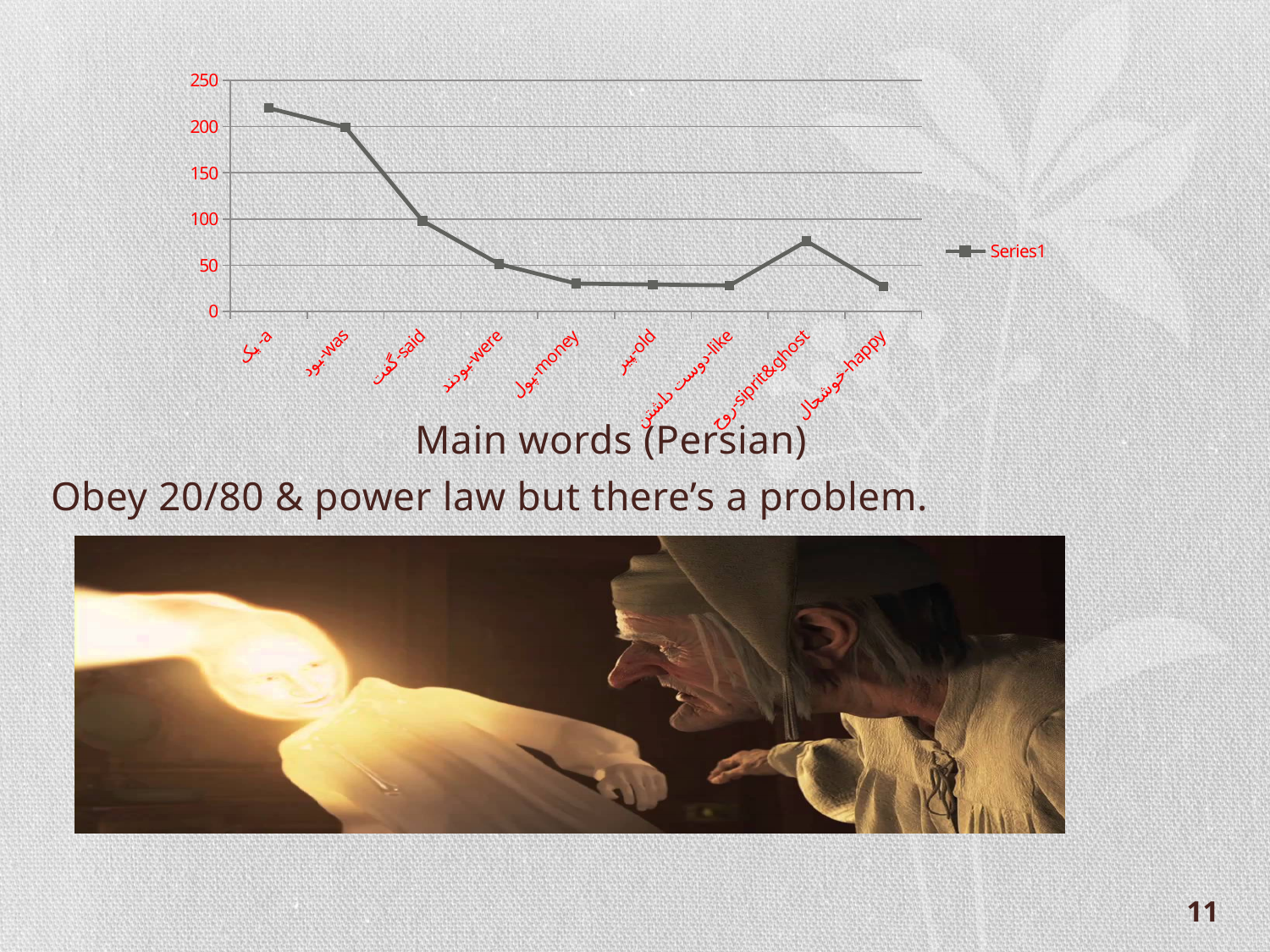
Is the value for said-گفت greater or less than 150? less Which has a larger value, said-گفت or were-بودند? said-گفت Is the value for money-پول greater or less than 50? less Is the value for a-یک greater or less than 200? greater Which category has the highest value in the chart? a-یک How many series does the chart's legend list? 1 What kind of chart is shown on the slide? line chart How many categories are plotted along the x axis of the chart? 9 What is the name of the series shown in the chart's legend? Series1 Which has a larger value, siprit&ghost-روح or money-پول? siprit&ghost-روح